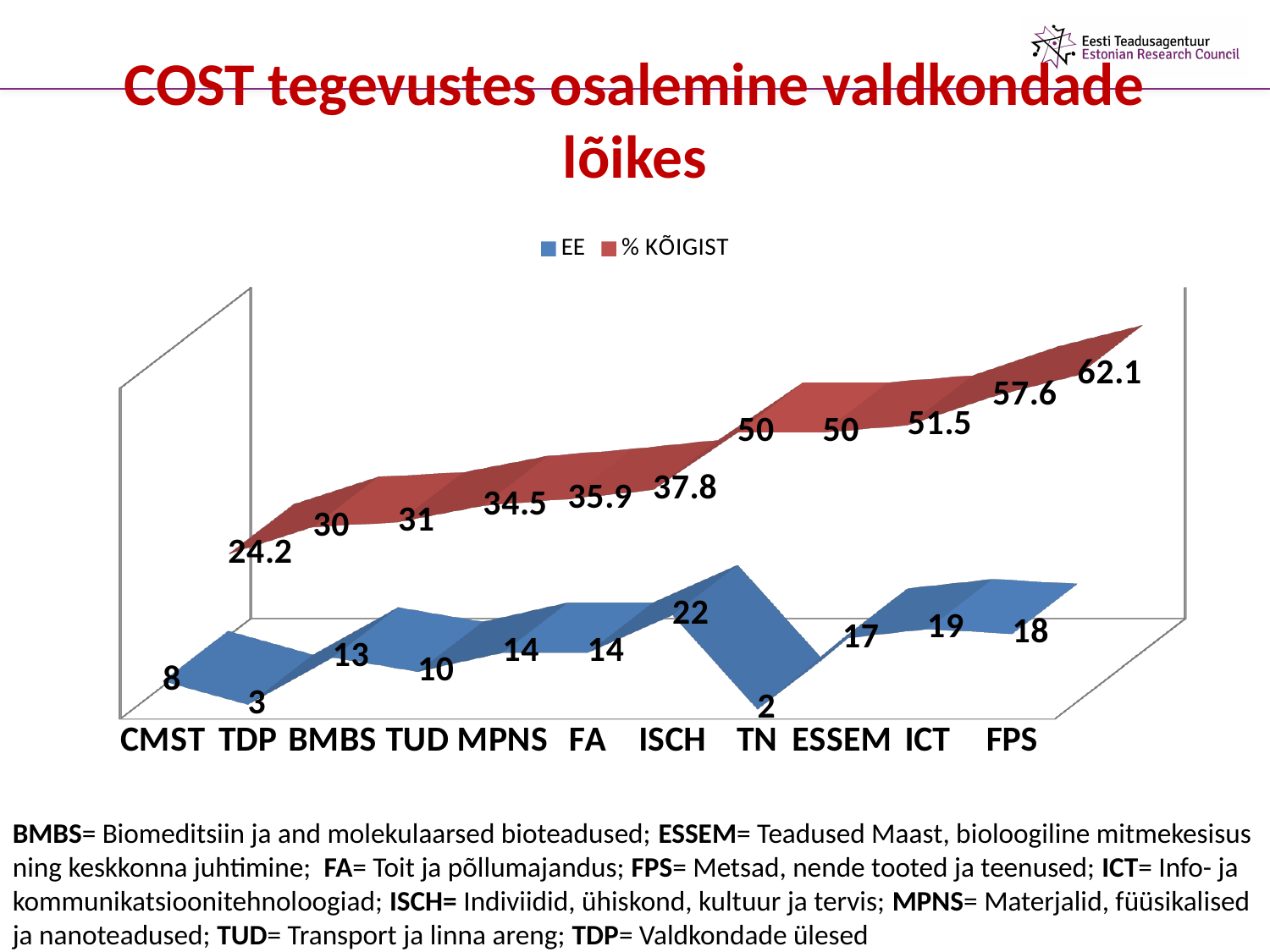
How many series does the legend list? 2 Which category has the lowest % KÕIGIST value? CMST Which category has the lowest EE value? TN Which has a larger EE value, ESSEM or BMBS? ESSEM How many categories are shown on the x axis? 11 What is the EE value for ISCH? 22 What is the difference between the EE values for ICT and TDP? 16 Does the % KÕIGIST series rise or fall from CMST to FPS? rise What is the difference between the % KÕIGIST values for FPS and ICT? 4.5 What is the % KÕIGIST value for FPS? 62.1 Which category has the highest EE value? ISCH What is the % KÕIGIST value for CMST? 24.2